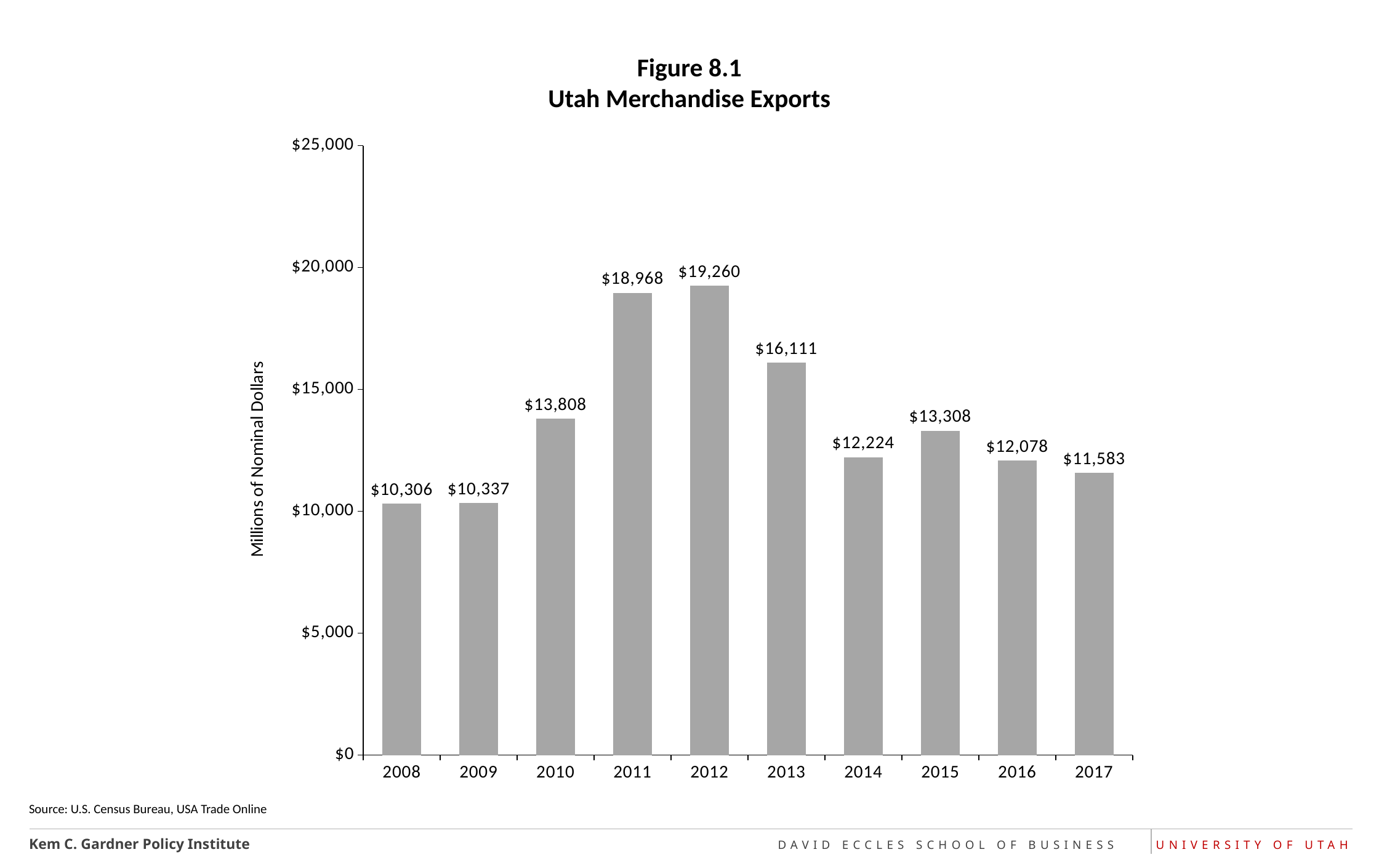
What is the difference between Utah merchandise exports in 2011 and 2010? $5,160 Which year had the lowest Utah merchandise exports? 2008 What kind of chart is shown on the slide? Bar chart Which year had the highest Utah merchandise exports? 2012 What is the y-axis label of the chart? Millions of Nominal Dollars Which year had higher Utah merchandise exports, 2014 or 2015? 2015 What was the value of Utah merchandise exports in 2012? $19,260 What was the value of Utah merchandise exports in 2017? $11,583 Is the value for 2013 greater or less than $15,000? greater What was the value of Utah merchandise exports in 2008? $10,306 How many years are shown on the chart? 10 What is the difference between Utah merchandise exports in 2012 and 2013? $3,149